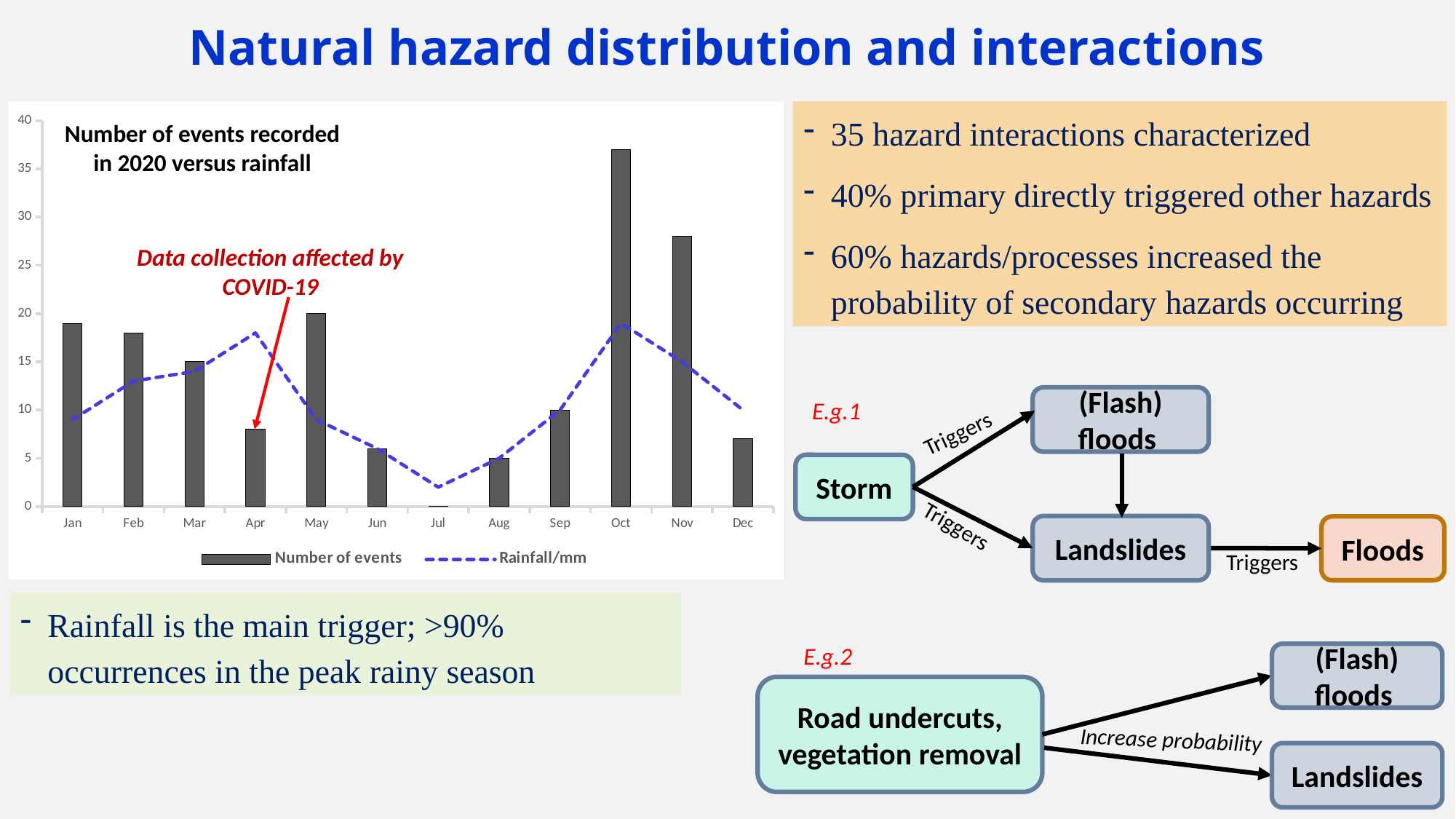
Is the number of events for Oct greater or less than 35? greater Is the number of events for Apr greater or less than 10? less Does the rainfall line rise or fall from Jul to Oct? rise How many months are shown on the x axis of the chart? 12 What kind of chart is shown on the left of the slide? bar chart with a dashed line Which month has more events recorded, Jun or Sep? Sep In the 'Number of events recorded in 2020 versus rainfall' chart, which month has the highest number of events? Oct How many series does the chart legend list? 2 Which month has more events recorded, Jan or Apr? Jan Is the number of events for Nov greater or less than 25? greater In the 'Number of events recorded in 2020 versus rainfall' chart, which month has the lowest number of events? Jul What are the two entries in the chart legend? Number of events; Rainfall/mm